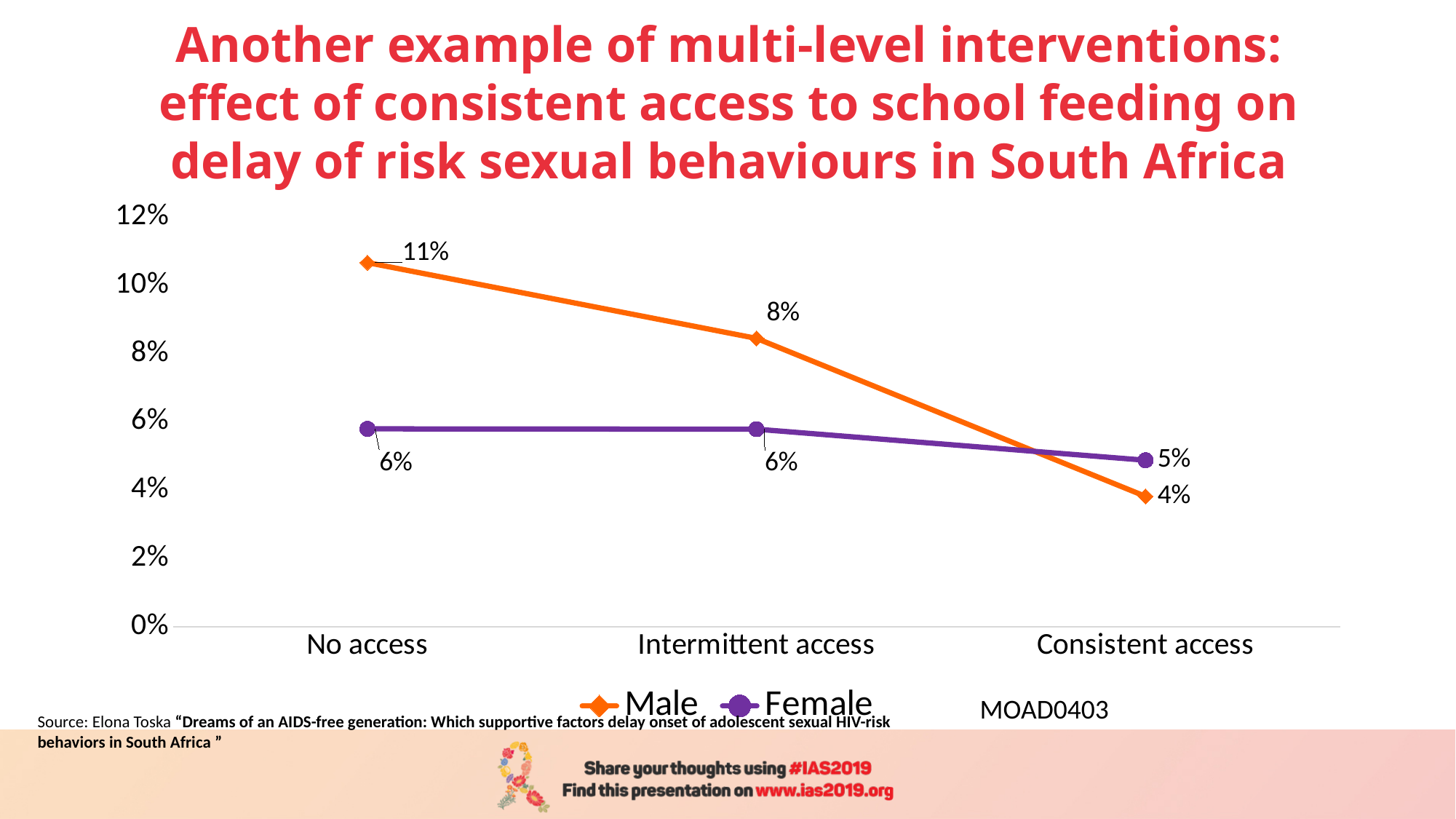
What is the Male value for Consistent access? 4% What is the Male value for No access? 11% What is the difference between the Male values for No access and Consistent access? 7% For Intermittent access, which series has the larger value, Male or Female? Male What is the Male value for Intermittent access? 8% Which access category has the highest Male value? No access What is the Female value for Consistent access? 5% How many access categories are shown on the x axis? 3 What kind of chart is shown on the slide? Line chart Which access category has the lowest Male value? Consistent access How many series does the legend list? 2 What is the Female value for No access? 6%